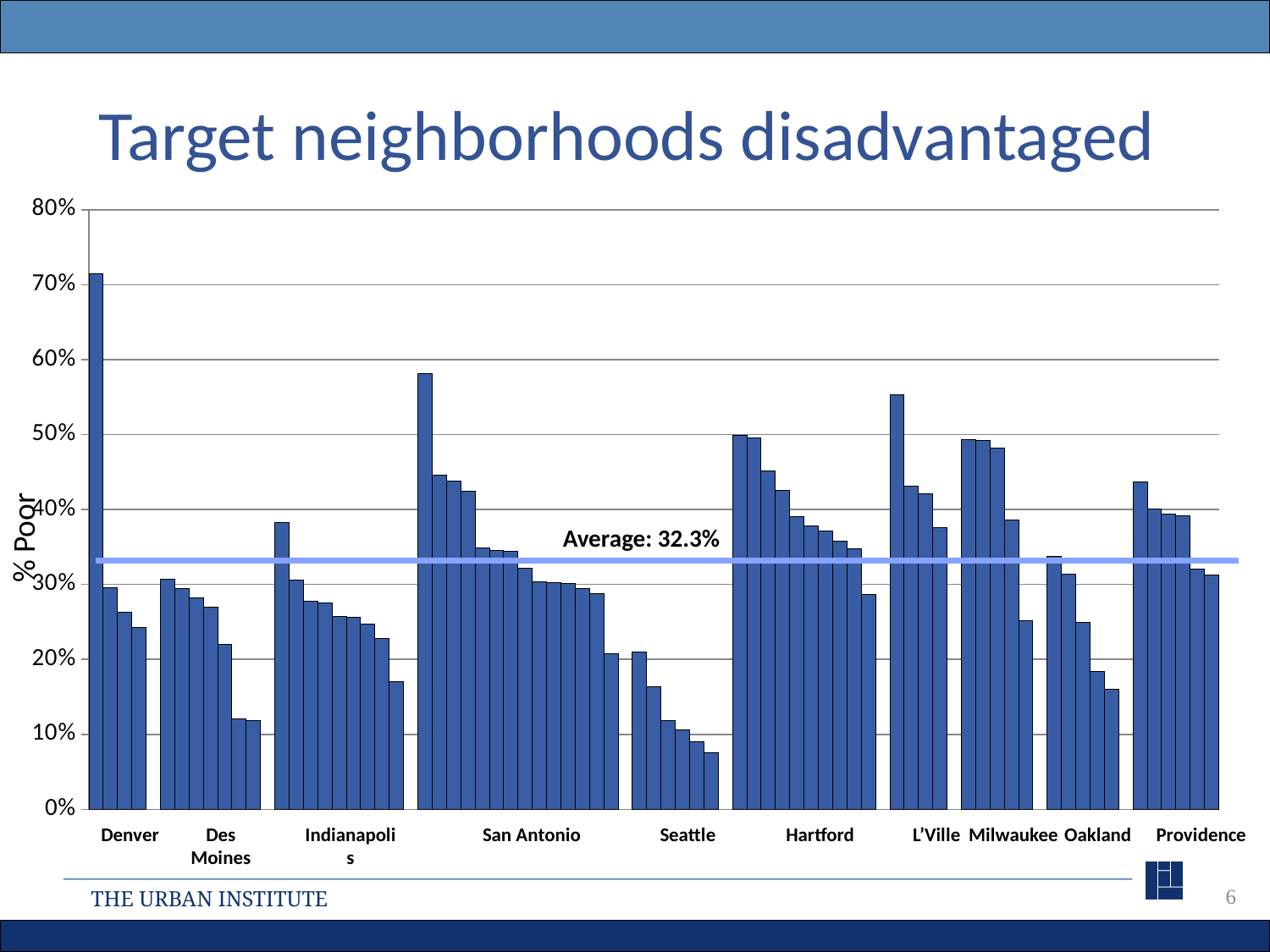
Is the tallest bar for Seattle greater or less than 30%? less What average value is printed on the chart? 32.3% What is the title of the chart on the slide? Target neighborhoods disadvantaged Is the tallest bar for L'Ville greater or less than 50%? greater What is the label on the y axis of the chart? % Poor How many cities are labeled along the x axis of the chart? 10 Which city contains the shortest bar on the chart? Seattle How many bars are shown for Denver? 4 Which city contains the tallest bar on the chart? Denver Is the tallest bar for Denver greater or less than 60%? greater Which is taller: the tallest bar for Seattle or the tallest bar for Oakland? Oakland What kind of chart is shown on the slide? bar chart